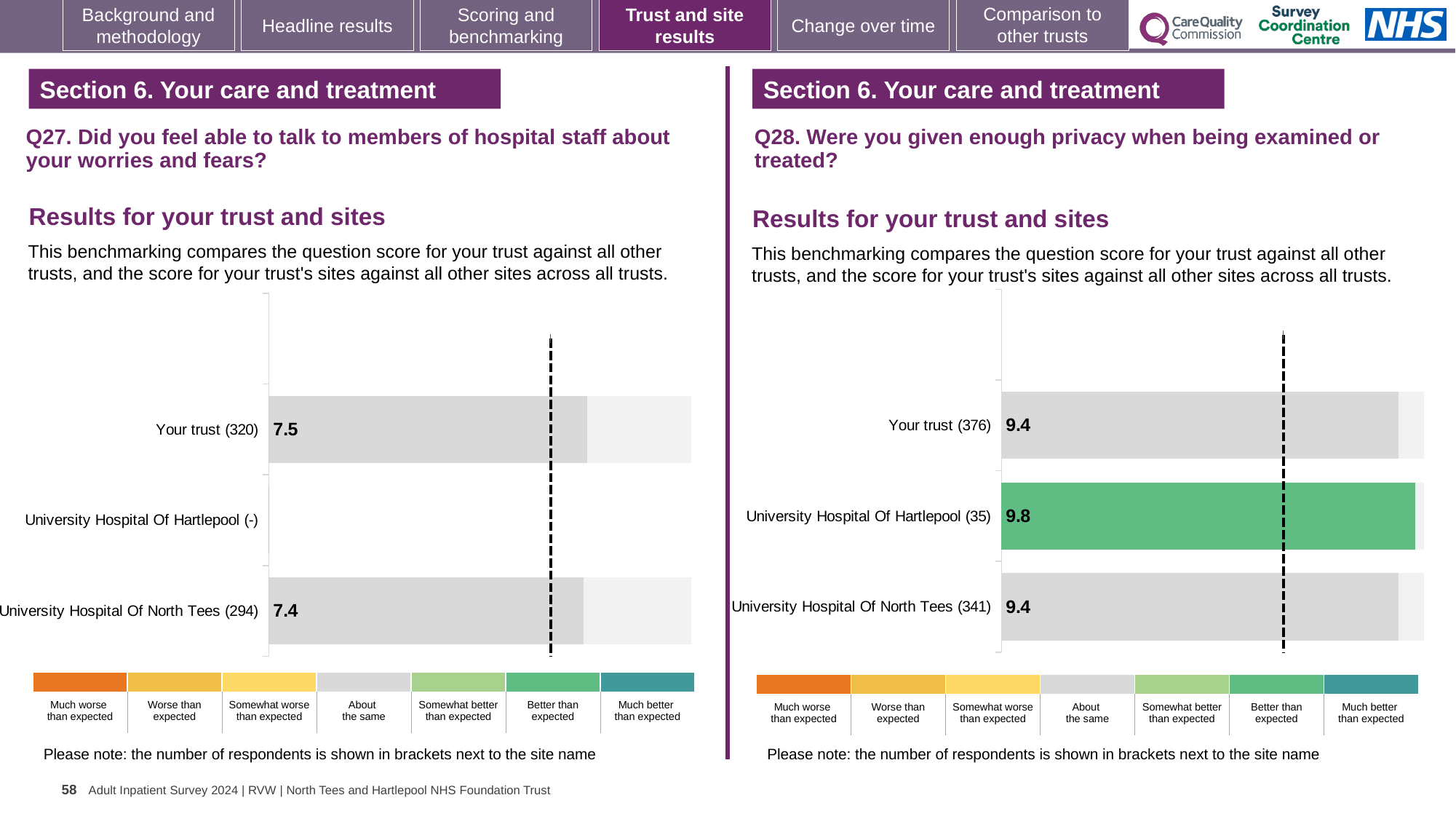
In the Q28 chart on the right, what is the score for University Hospital Of Hartlepool? 9.8 In the Q27 chart on the left, what is the score for University Hospital Of North Tees? 7.4 In the Q27 chart on the left, what is the score for Your trust? 7.5 In the Q27 chart on the left, what is the difference between the score for Your trust and the score for University Hospital Of North Tees? 0.1 In the Q28 chart on the right, which site or trust has the highest score? University Hospital Of Hartlepool In the Q28 chart on the right, how many categories (trust and sites) are listed? 3 In the Q28 chart on the right, what is the score for University Hospital Of North Tees? 9.4 In the Q28 chart on the right, how many respondents are shown in brackets for University Hospital Of Hartlepool? 35 In the Q28 chart on the right, what is the difference between the score for University Hospital Of Hartlepool and the score for Your trust? 0.4 In the Q28 chart on the right, which benchmark category does the green bar for University Hospital Of Hartlepool correspond to in the legend? Better than expected In the Q27 chart on the left, how many respondents are shown in brackets for Your trust? 320 What kind of chart is used in the Q27 chart on the left? Bar chart